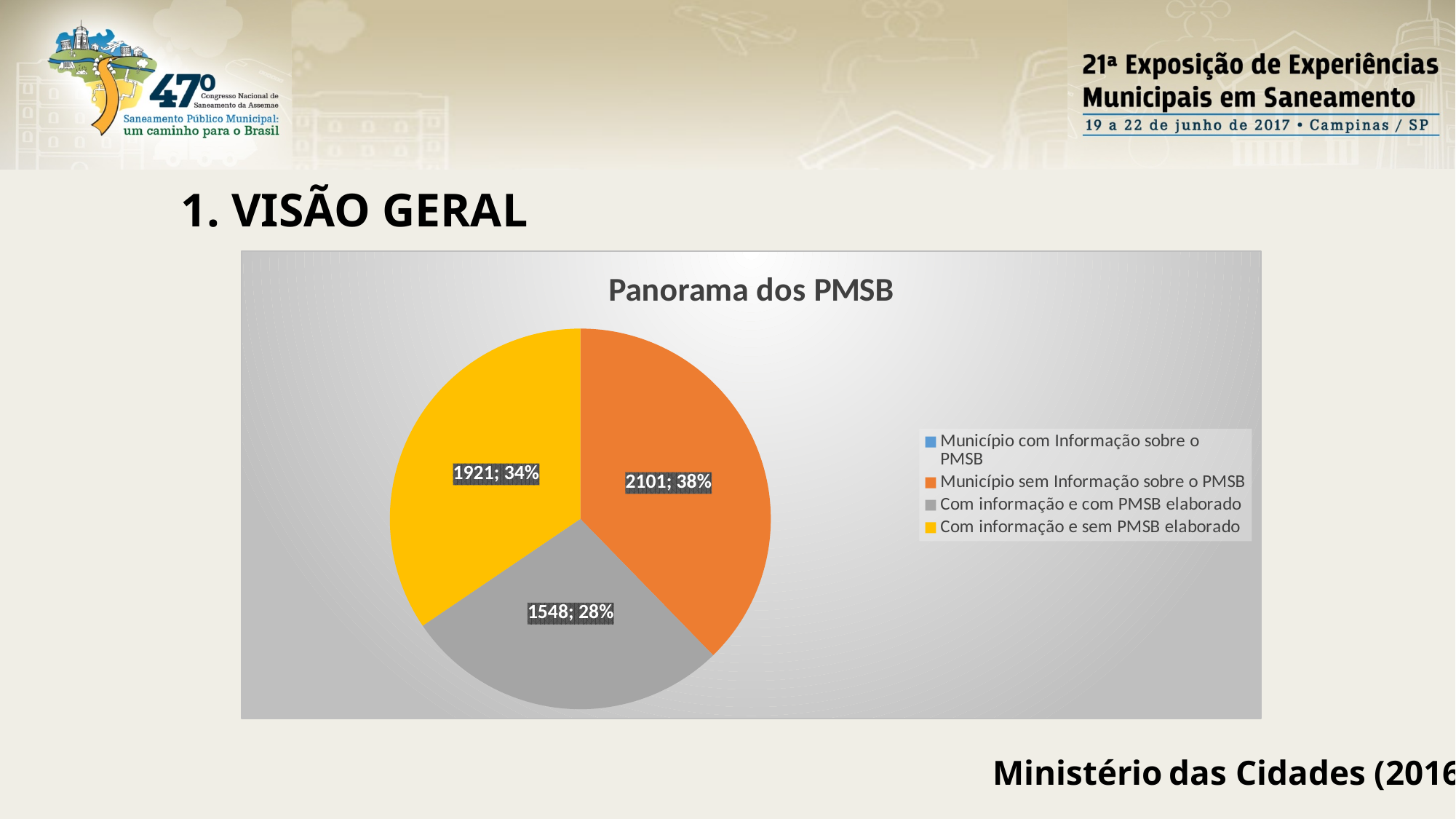
How many entries does the chart's legend list? 4 What value is shown for 'Município sem Informação sobre o PMSB'? 2101 What is the title of the chart? Panorama dos PMSB Which visible slice is the largest? Município sem Informação sobre o PMSB What is the difference between the values for 'Município sem Informação sobre o PMSB' and 'Com informação e sem PMSB elaborado'? 180 What value is shown for 'Com informação e sem PMSB elaborado'? 1921 What percentage share does 'Com informação e com PMSB elaborado' have? 28% What kind of chart is shown on the slide? Pie chart Which colour represents 'Com informação e sem PMSB elaborado'? Yellow How many slices are visible in the pie chart? 3 Which visible slice is the smallest? Com informação e com PMSB elaborado What percentage share does 'Município sem Informação sobre o PMSB' have? 38%